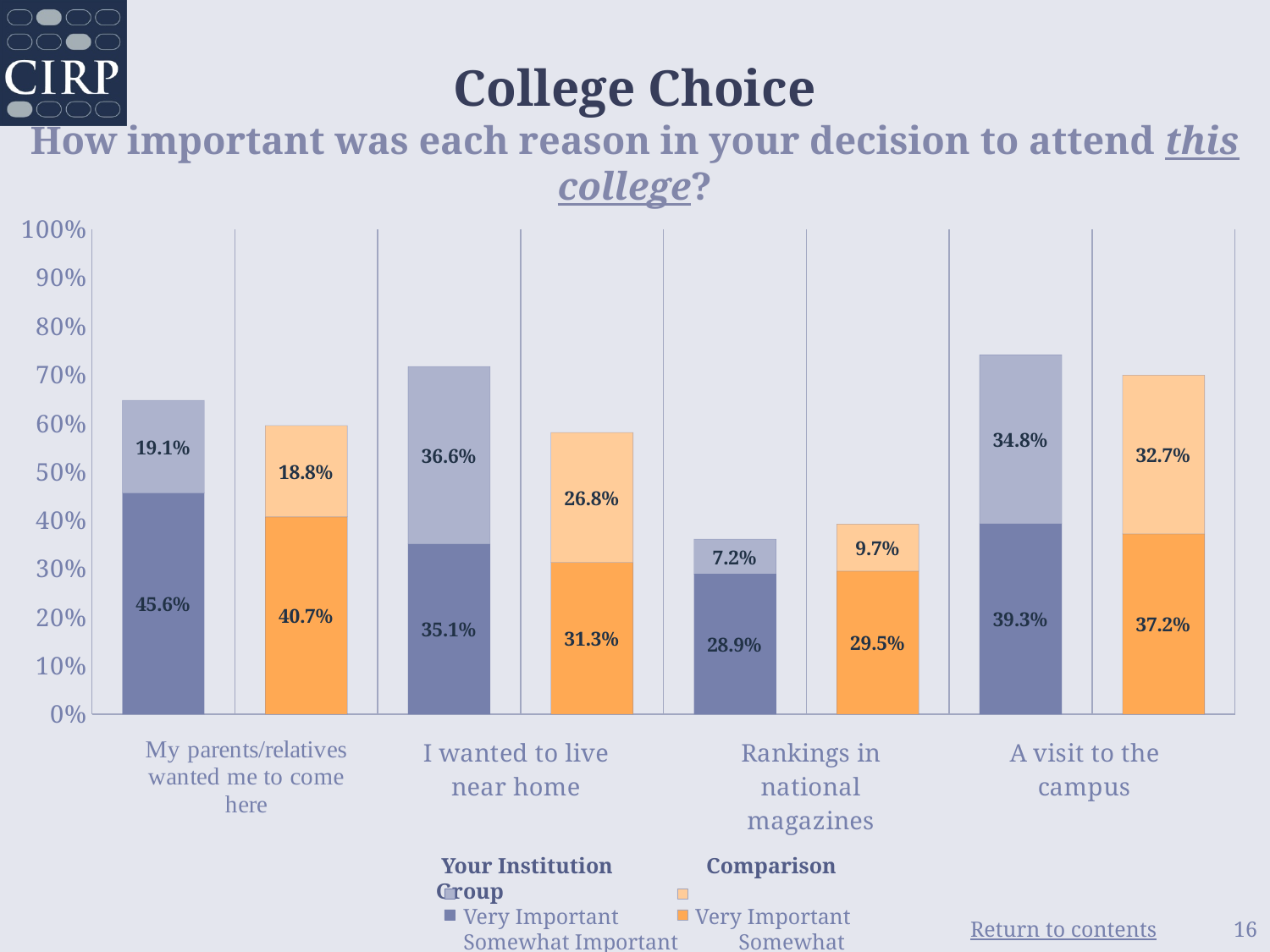
How many reasons (categories) are shown on the x axis? 4 Which reason has the highest Very Important percentage for Your Institution? I wanted to live near home What is the total stacked percentage for the Comparison Group for "I wanted to live near home"? 58.1% What type of chart is shown on the slide? Stacked bar chart What percentage of Your Institution respondents rated "Rankings in national magazines" as Somewhat Important? 28.9% What percentage of Your Institution respondents rated "My parents/relatives wanted me to come here" as Very Important? 19.1% What is the difference between the Very Important percentages for Your Institution and the Comparison Group for "My parents/relatives wanted me to come here"? 0.3% For "I wanted to live near home", which is larger: the Somewhat Important percentage for Your Institution or for the Comparison Group? Your Institution Which reason has the lowest Somewhat Important percentage for the Comparison Group? Rankings in national magazines What percentage of the Comparison Group rated "A visit to the campus" as Somewhat Important? 37.2% What is the total stacked percentage (Very Important plus Somewhat Important) for Your Institution for "A visit to the campus"? 74.1%